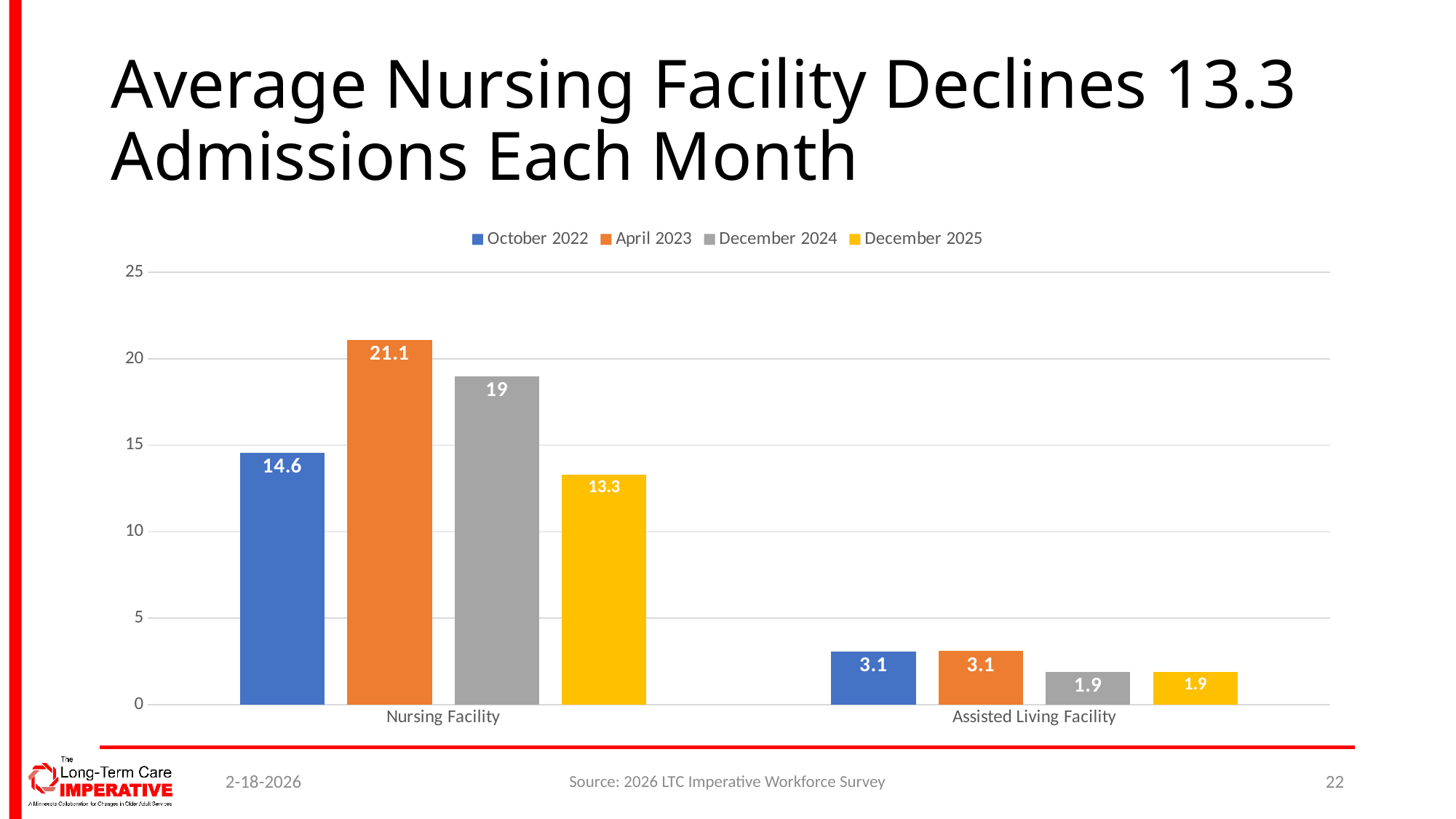
How many series does the legend list? 4 How many categories are shown on the x axis? 2 Is the December 2024 value for Nursing Facility greater or less than 15? greater Which series has the highest value for Nursing Facility? April 2023 What is the value for Nursing Facility in December 2025? 13.3 What is the value for Assisted Living Facility in October 2022? 3.1 What is the difference between the April 2023 and December 2025 values for Nursing Facility? 7.8 What is the difference between the October 2022 and December 2024 values for Assisted Living Facility? 1.2 Which is larger for Nursing Facility: the October 2022 value or the December 2024 value? December 2024 What is the value for Nursing Facility in April 2023? 21.1 Which series has the lowest value for Nursing Facility? December 2025 What kind of chart is shown on the slide? Bar chart